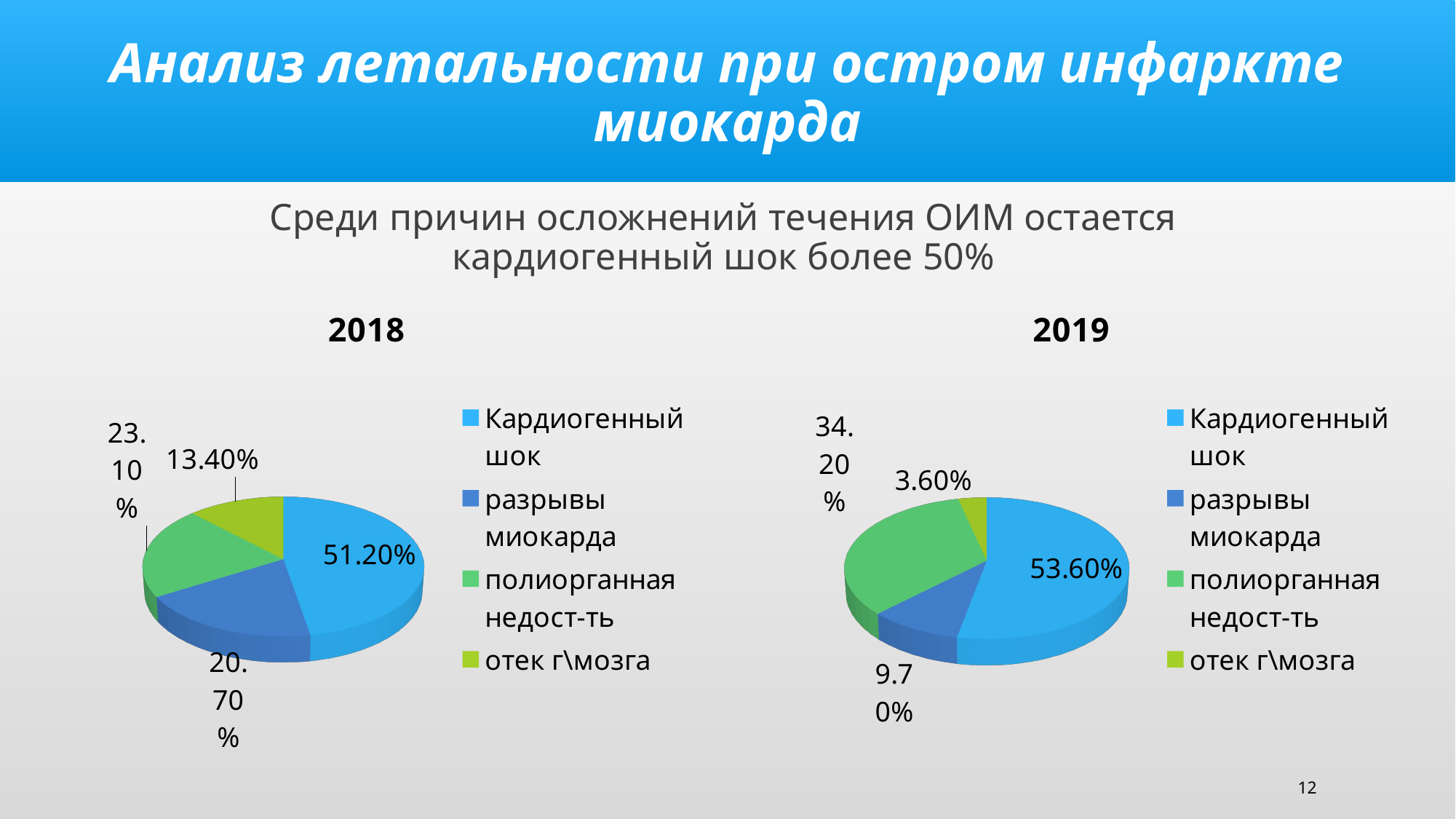
In the 2018 chart, what is the value for Кардиогенный шок? 51.20% In the 2019 chart, what is the value for разрывы миокарда? 9.70% In the 2019 chart, what is the difference between полиорганная недост-ть and отек г\мозга? 30.60% In the 2019 chart, what is the value for полиорганная недост-ть? 34.20% How many entries does the legend of the 2018 chart list? 4 In the 2018 chart, which is larger: полиорганная недост-ть or разрывы миокарда? полиорганная недост-ть In the 2018 chart, which category has the largest slice? Кардиогенный шок How many slices does the 2019 pie chart have? 4 What type of chart is the 2018 chart? Pie chart In the 2019 chart, which category has the smallest slice? отек г\мозга What is the difference between the Кардиогенный шок values in the 2019 chart and the 2018 chart? 2.40% In the 2018 chart, what is the value for отек г\мозга? 13.40%